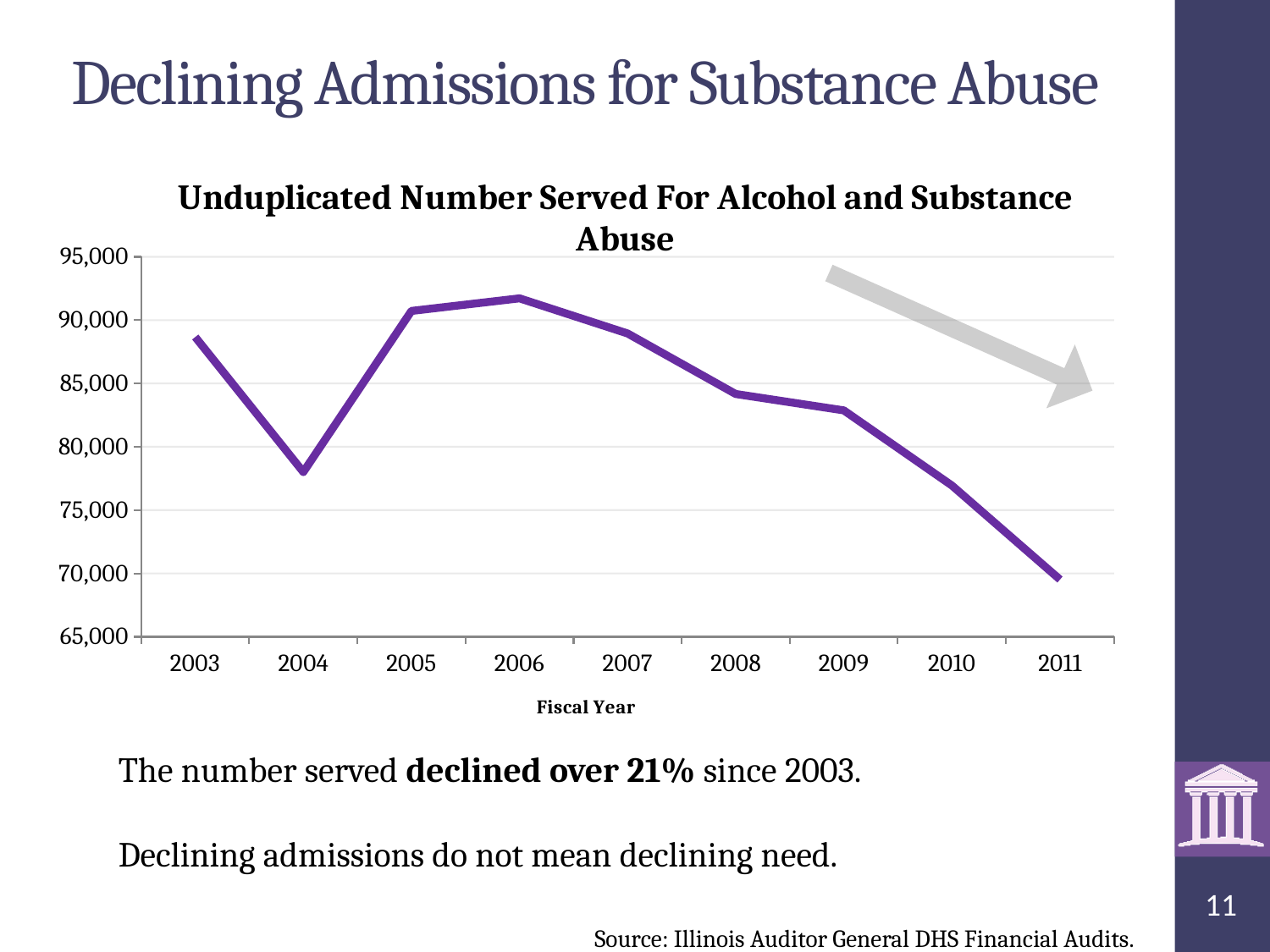
Is the value for 2006 greater or less than 90,000? greater Which fiscal year has the highest number served? 2006 How many fiscal years are plotted on the chart? 9 What kind of chart is shown on the slide? line chart Is the value for 2011 greater or less than 75,000? less Do the values rise or fall from 2006 to 2011? fall Is the value for 2009 greater or less than 85,000? less Which fiscal year has a larger number served, 2003 or 2004? 2003 What is the title of the chart? Unduplicated Number Served For Alcohol and Substance Abuse What is the label on the x axis of the chart? Fiscal Year Which fiscal year has the lowest number served? 2011